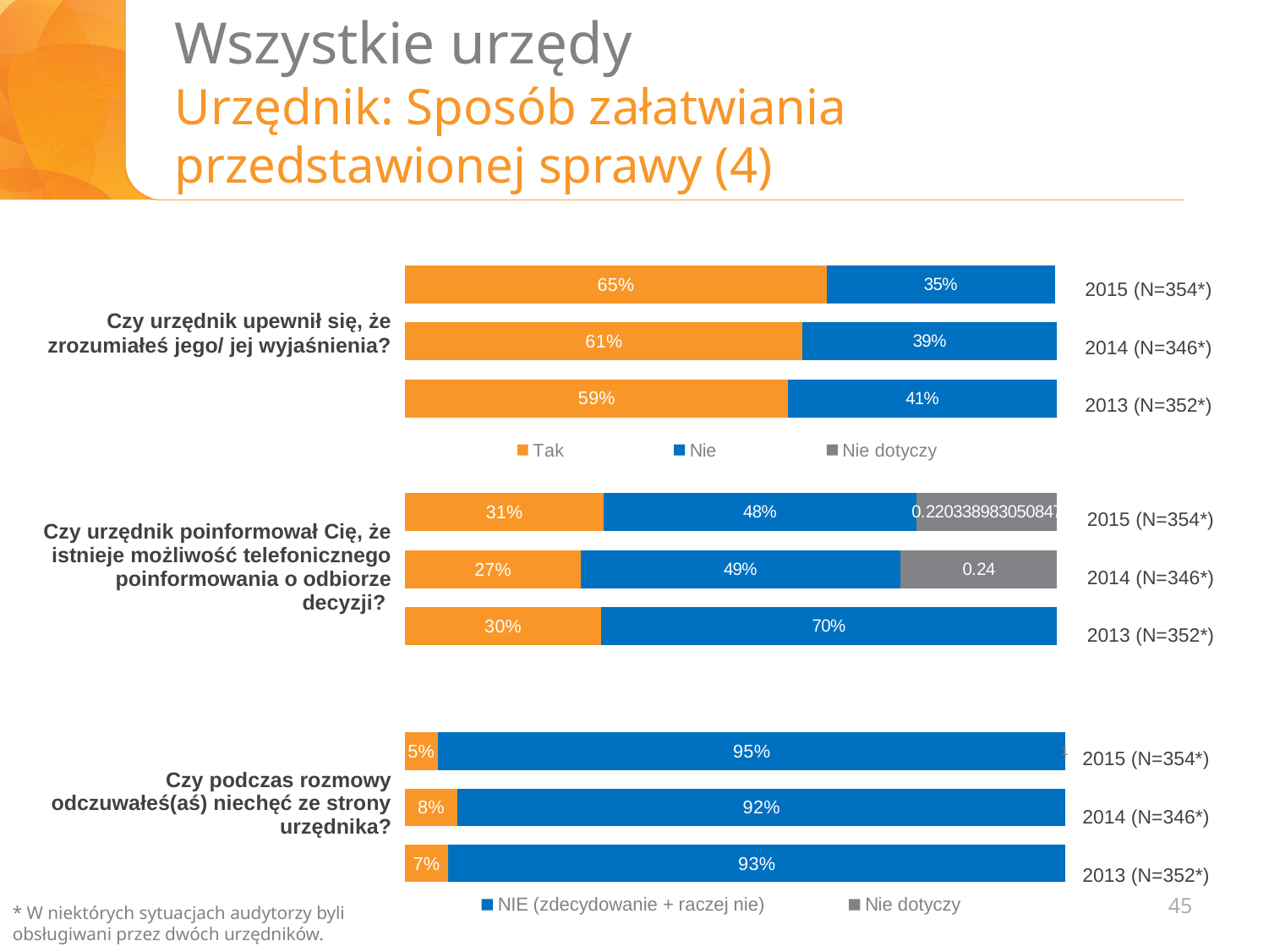
In the chart for "Czy urzędnik upewnił się, że zrozumiałeś jego/ jej wyjaśnienia?", what is the difference between the "Tak" values for 2015 and 2013? 6% In the chart for "Czy urzędnik poinformował Cię, że istnieje możliwość telefonicznego poinformowania o odbiorze decyzji?", which year has the lowest "Tak" value? 2014 (N=346*) In the chart for "Czy urzędnik poinformował Cię, że istnieje możliwość telefonicznego poinformowania o odbiorze decyzji?", what is the "Nie" value for 2013 (N=352*)? 70% In the chart for "Czy podczas rozmowy odczuwałeś(aś) niechęć ze strony urzędnika?", what is the "NIE (zdecydowanie + raczej nie)" value for 2015 (N=354*)? 95% In the chart for "Czy podczas rozmowy odczuwałeś(aś) niechęć ze strony urzędnika?", which year has the highest "NIE (zdecydowanie + raczej nie)" value? 2015 (N=354*) What kind of chart is used on this slide? Stacked bar chart In the chart for "Czy urzędnik upewnił się, że zrozumiałeś jego/ jej wyjaśnienia?", how many entries does the legend list? 3 In the chart for "Czy urzędnik poinformował Cię, że istnieje możliwość telefonicznego poinformowania o odbiorze decyzji?", what is the "Tak" value for 2014 (N=346*)? 27% In the chart for "Czy podczas rozmowy odczuwałeś(aś) niechęć ze strony urzędnika?", is the "NIE (zdecydowanie + raczej nie)" value for 2014 larger or smaller than for 2013? smaller In the chart for "Czy urzędnik upewnił się, że zrozumiałeś jego/ jej wyjaśnienia?", which year has the highest "Tak" value? 2015 (N=354*) In the chart for "Czy urzędnik upewnił się, że zrozumiałeś jego/ jej wyjaśnienia?", what is the "Tak" value for 2015 (N=354*)? 65% In the chart for "Czy urzędnik upewnił się, że zrozumiałeś jego/ jej wyjaśnienia?", what is the "Nie" value for 2013 (N=352*)? 41%